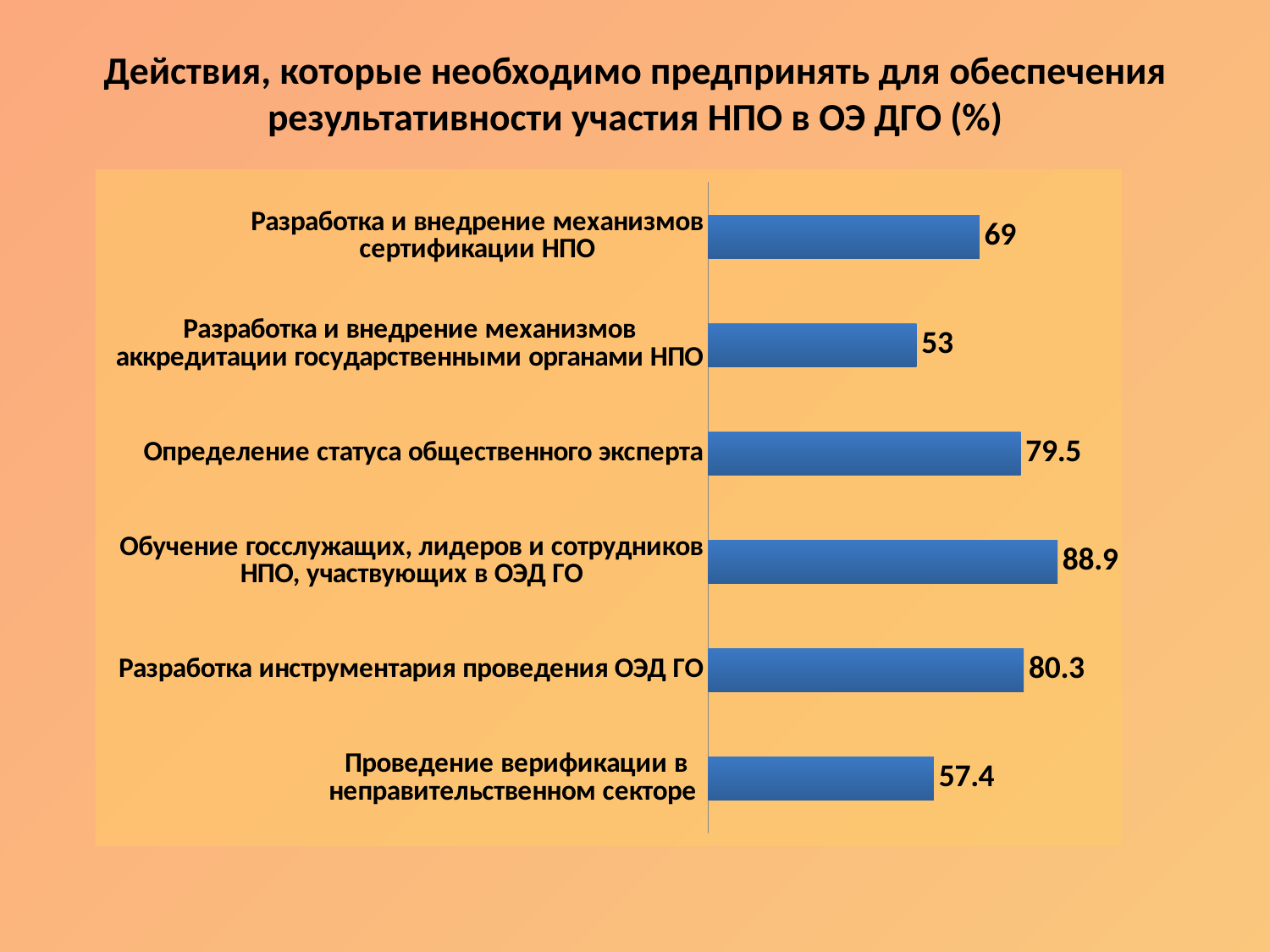
Which category has the lowest value? Разработка и внедрение механизмов аккредитации государственными органами НПО What is the difference between the values for "Разработка инструментария проведения ОЭД ГО" and "Определение статуса общественного эксперта"? 0.8 What is the difference between the values for "Разработка и внедрение механизмов сертификации НПО" and "Разработка и внедрение механизмов аккредитации государственными органами НПО"? 16 Which is larger: the value for "Проведение верификации в неправительственном секторе" or the value for "Разработка и внедрение механизмов сертификации НПО"? Разработка и внедрение механизмов сертификации НПО How many categories are shown in the chart? 6 What is the value for "Обучение госслужащих, лидеров и сотрудников НПО, участвующих в ОЭД ГО"? 88.9 What is the title of the chart? Действия, которые необходимо предпринять для обеспечения результативности участия НПО в ОЭ ДГО (%) What is the value for "Определение статуса общественного эксперта"? 79.5 What kind of chart is shown on the slide? Bar chart Which category has the highest value? Обучение госслужащих, лидеров и сотрудников НПО, участвующих в ОЭД ГО What is the value for "Разработка и внедрение механизмов сертификации НПО"? 69 What is the value for "Проведение верификации в неправительственном секторе"? 57.4